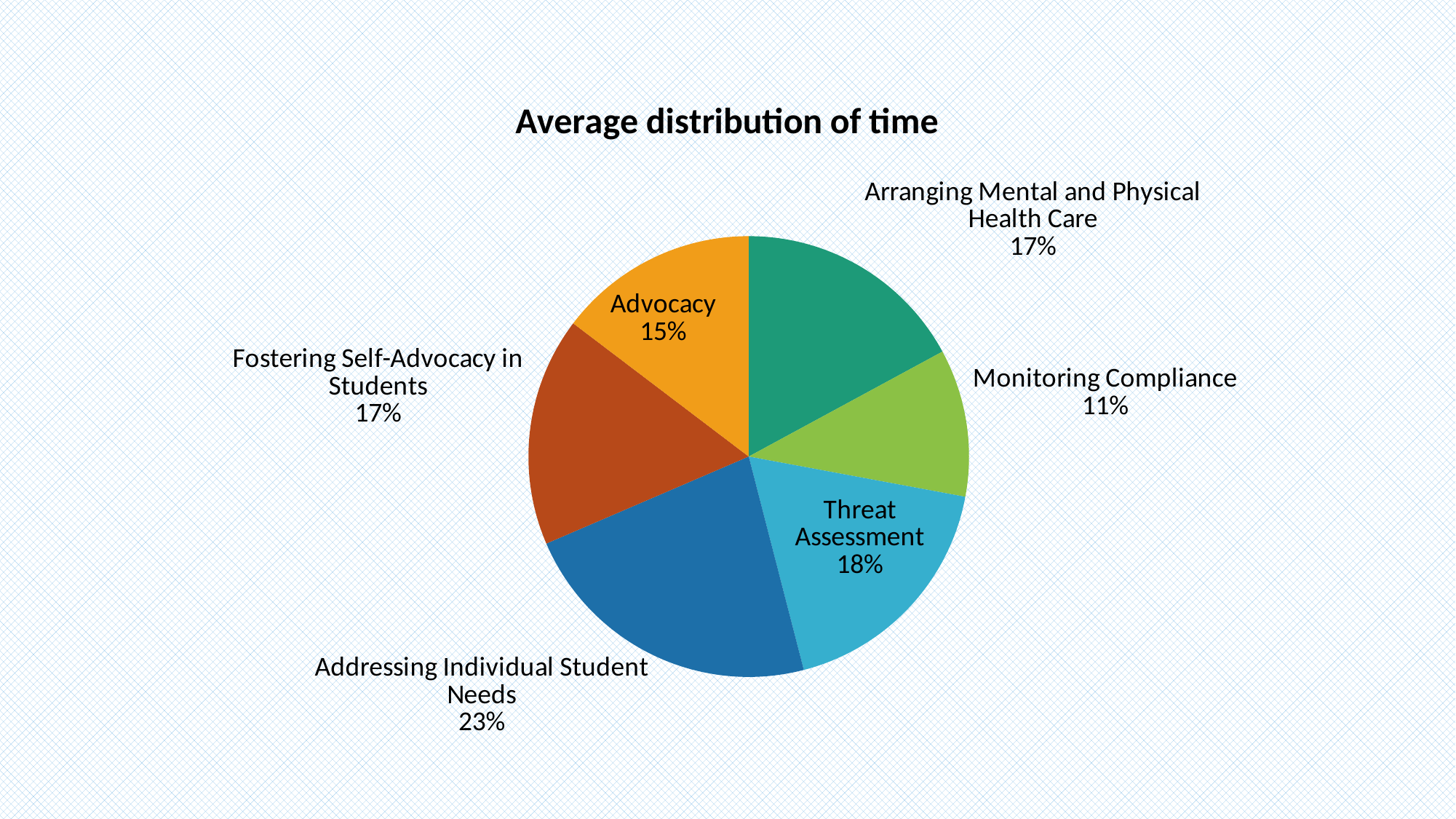
What share of time is spent on Addressing Individual Student Needs? 23% What is the combined share of Arranging Mental and Physical Health Care and Fostering Self-Advocacy in Students? 34% Which category takes the smallest share of time? Monitoring Compliance Which category takes the largest share of time? Addressing Individual Student Needs Which is larger: the share for Threat Assessment or the share for Advocacy? Threat Assessment What share of time is spent on Monitoring Compliance? 11% What is the title of the chart? Average distribution of time What share of time is spent on Advocacy? 15% What is the difference in percentage points between Addressing Individual Student Needs and Monitoring Compliance? 12 What kind of chart is shown on the slide? Pie chart How many categories does the pie chart show? 6 What share of time is spent on Threat Assessment? 18%